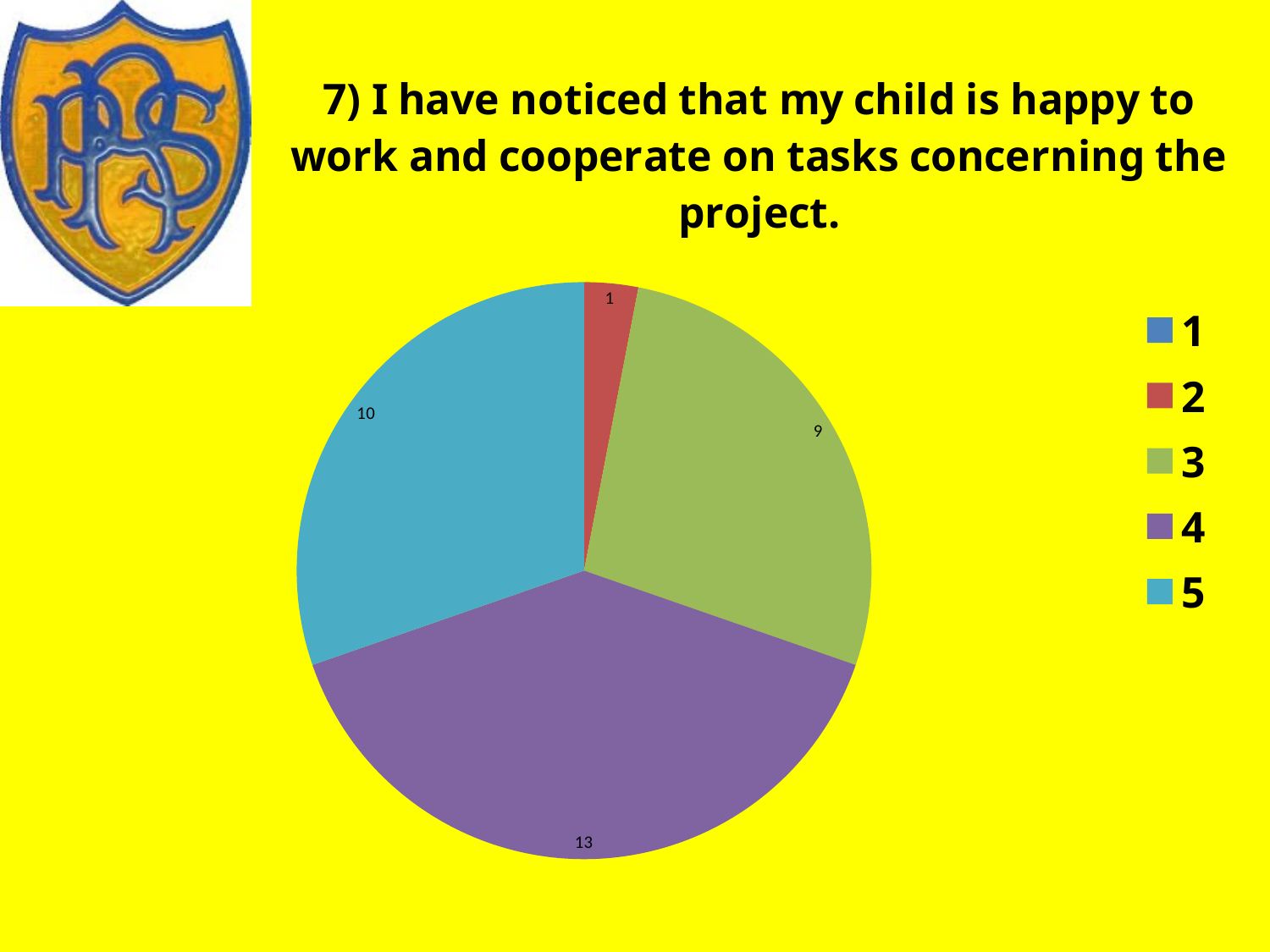
What is the value for category 5 in the pie chart? 10 How many entries does the legend of the pie chart list? 5 What colour is the slice for category 4 in the pie chart? purple Which labelled slice in the pie chart has the smallest value? 2 What is the difference between the values for category 4 and category 5? 3 What type of chart is shown on the slide? pie chart Which category has the largest slice in the pie chart? 4 What is the value for category 4 in the pie chart? 13 What is the value for category 3 in the pie chart? 9 Which is larger, the value for category 3 or the value for category 5? 5 What is the value for category 2 in the pie chart? 1 What is the difference between the values for category 3 and category 2? 8